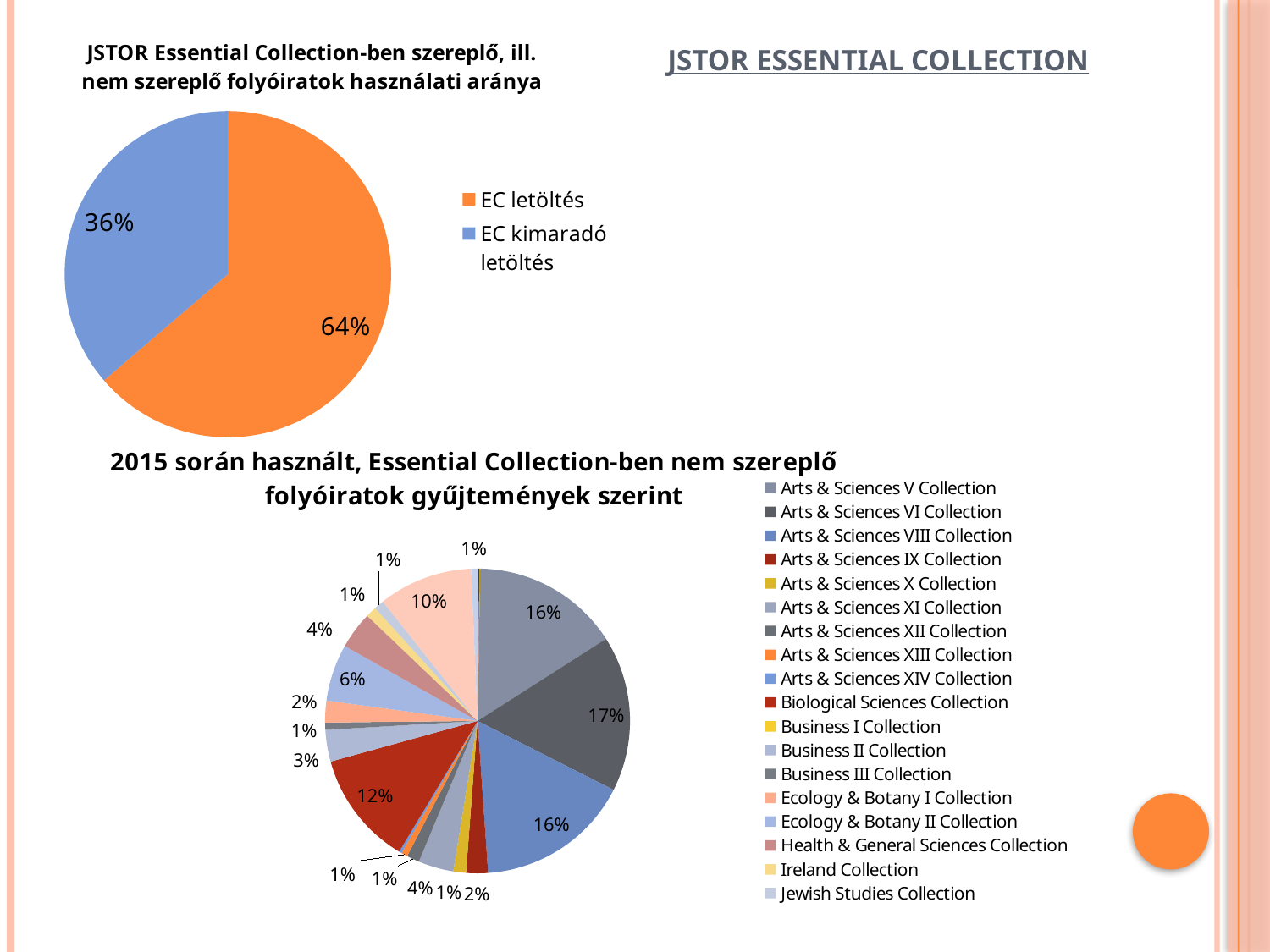
In the bottom pie chart, what share is shown for Ecology & Botany I Collection? 2% In the bottom pie chart, what share is shown for Arts & Sciences VI Collection? 17% In the top pie chart, what share is shown for EC letöltés? 64% What is the title of the bottom chart? 2015 során használt, Essential Collection-ben nem szereplő folyóiratok gyűjtemények szerint In the bottom pie chart, what share is shown for Biological Sciences Collection? 12% In the bottom pie chart, which collection has the largest share? Arts & Sciences VI Collection How many series does the legend of the top chart list? 2 What kind of chart is the top chart on the slide? Pie chart In the top pie chart, what is the difference in percentage points between EC letöltés and EC kimaradó letöltés? 28 How many collections does the legend of the bottom chart list? 18 In the top pie chart, what share is shown for EC kimaradó letöltés? 36% In the top pie chart, which slice is larger, EC letöltés or EC kimaradó letöltés? EC letöltés